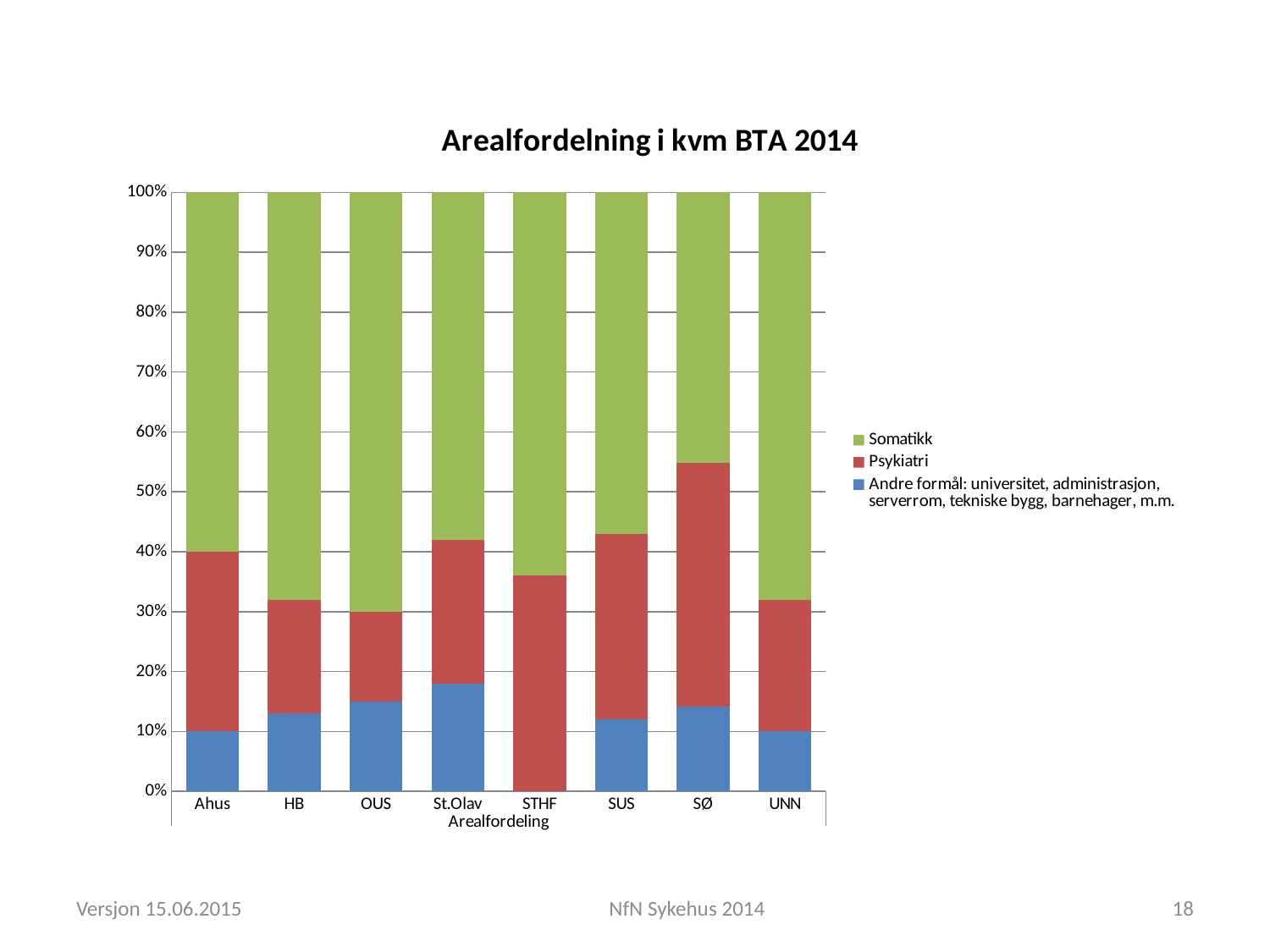
Is the Somatikk share for SØ greater or less than 50%? less Which hospital has the largest Somatikk share? OUS How many series does the legend list? 3 Which hospital shows no 'Andre formål' segment at all? STHF Which hospital has the smallest Somatikk share? SØ How many hospitals (categories) are shown on the x axis? 8 What share does 'Andre formål' make up for Ahus? 10% What share does 'Andre formål' make up for UNN? 10% What is the title of the chart? Arealfordelning i kvm BTA 2014 Which hospital has a larger Somatikk share, Ahus or HB? HB What type of chart is shown on the slide? Stacked bar chart Which hospital has the largest 'Andre formål' share? St.Olav